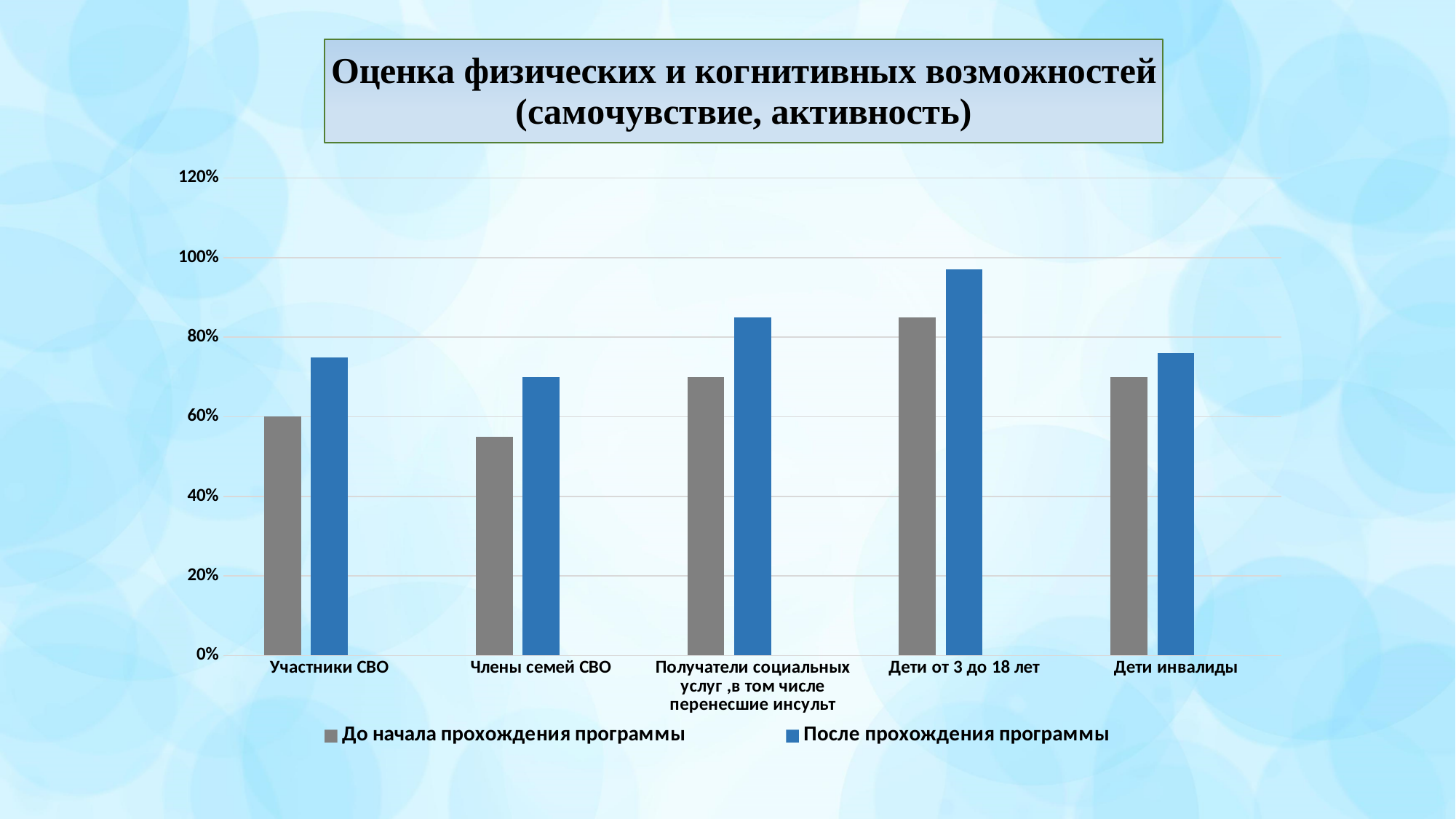
How many series does the legend list? 2 Is the value for Получатели социальных услуг, в том числе перенесшие инсульт in the series После прохождения программы greater or less than 80%? greater What kind of chart is shown on the slide? bar chart Is the value for Дети от 3 до 18 лет in the series После прохождения программы greater or less than 80%? greater How many categories are shown on the x axis? 5 Is the value for Члены семей СВО in the series До начала прохождения программы greater or less than 60%? less What colour are the bars for the series После прохождения программы? blue In the series До начала прохождения программы, which is larger: Дети от 3 до 18 лет or Участники СВО? Дети от 3 до 18 лет In the series После прохождения программы, which is larger: Получатели социальных услуг, в том числе перенесшие инсульт or Дети инвалиды? Получатели социальных услуг, в том числе перенесшие инсульт Which category has the lowest value in the series До начала прохождения программы? Члены семей СВО What is the value for Участники СВО in the series До начала прохождения программы? 60% Which category has the highest value in the series После прохождения программы? Дети от 3 до 18 лет